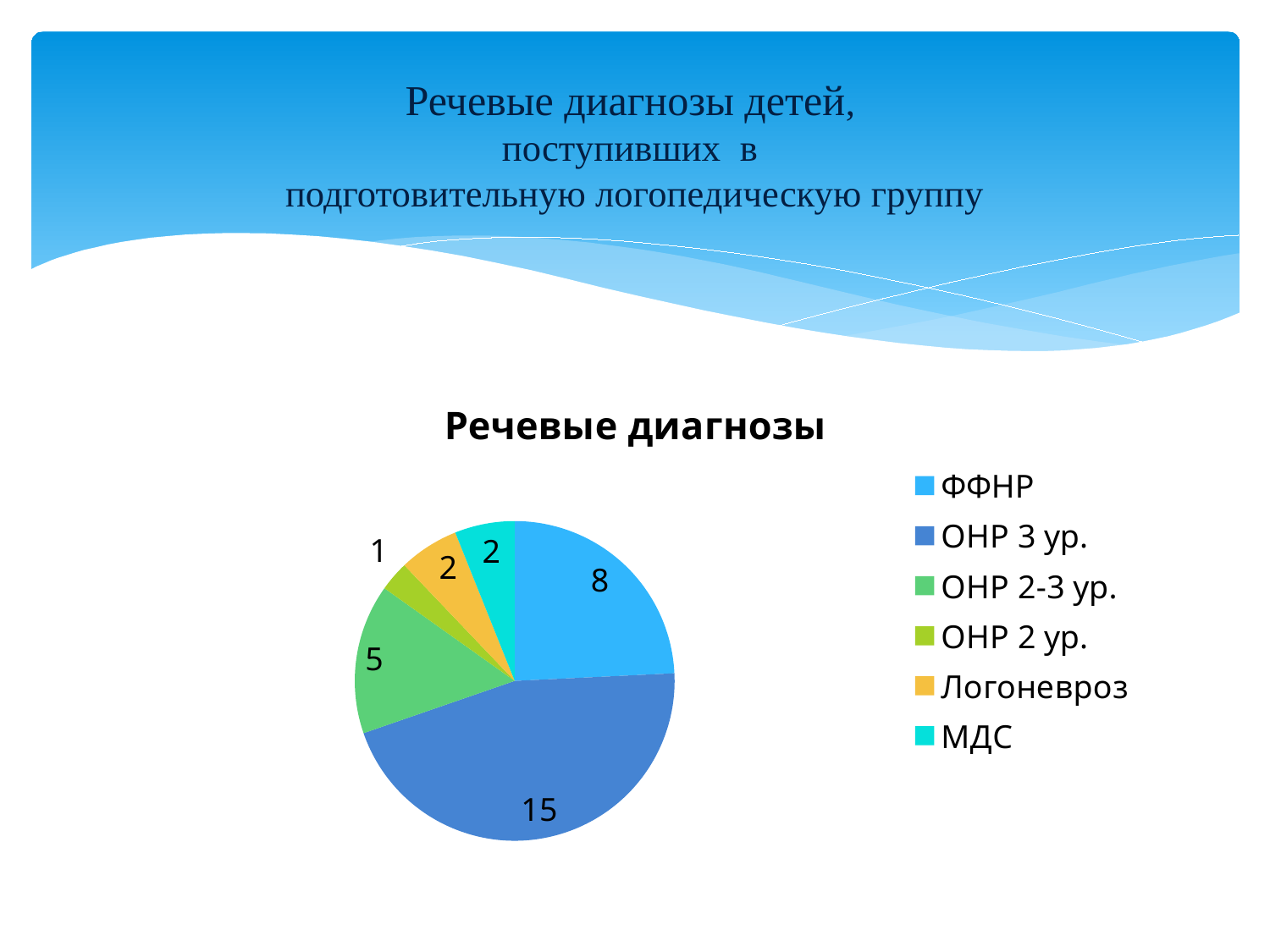
Which colour is used for the ОНР 3 ур. slice? dark blue Which category has the smallest slice? ОНР 2 ур. What is the value for Логоневроз? 2 What is the value for ОНР 3 ур.? 15 What is the chart's title? Речевые диагнозы What is the value for ФФНР? 8 What kind of chart is shown on the slide? pie chart Which category has the largest slice? ОНР 3 ур. What is the value for ОНР 2-3 ур.? 5 What is the difference between the values for ОНР 3 ур. and ФФНР? 7 Which is larger, the value for ОНР 2-3 ур. or the value for МДС? ОНР 2-3 ур. How many categories does the legend list? 6